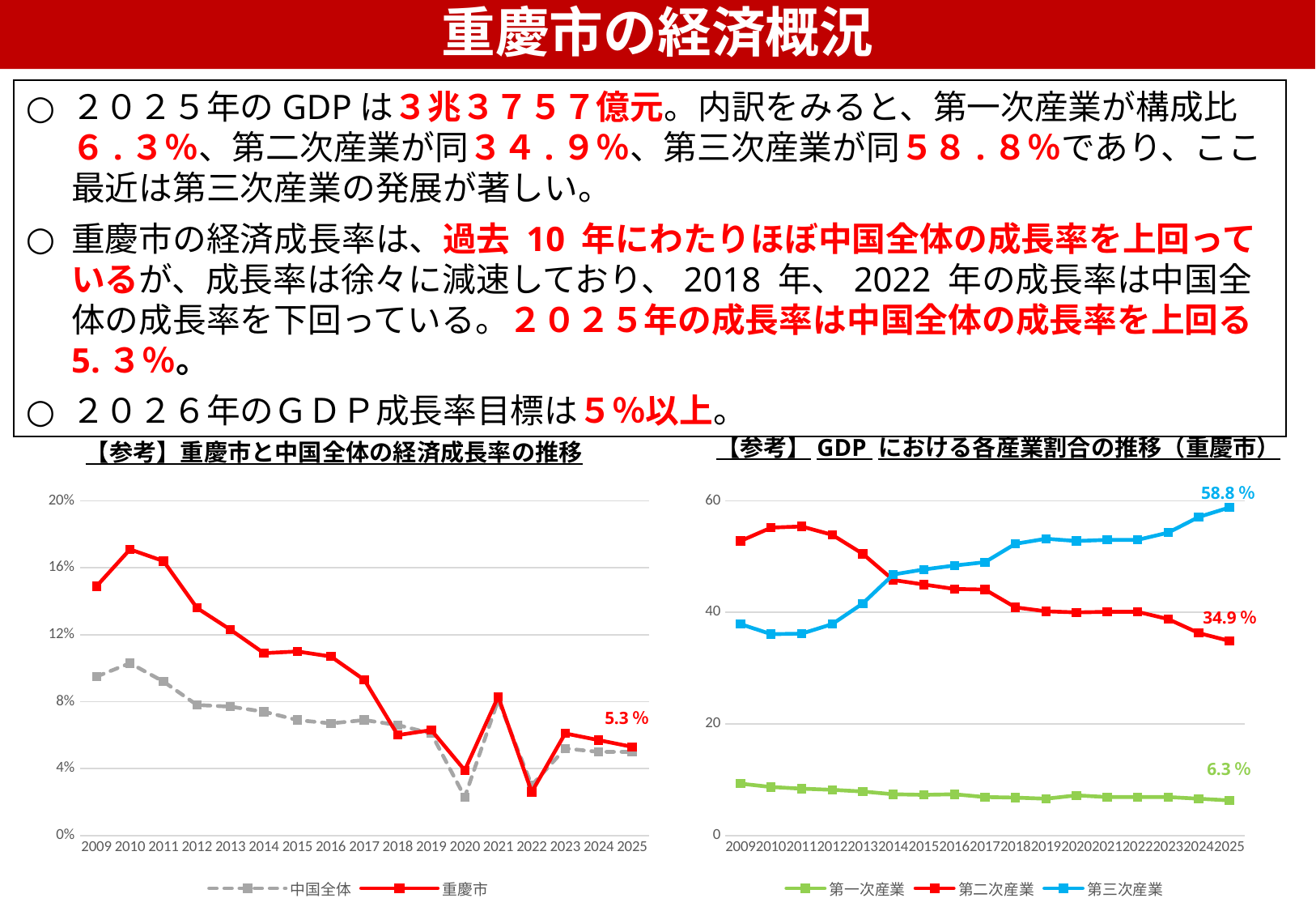
On the right chart (GDP における各産業割合の推移), which industry has the lowest share in 2025? 第一次産業 On the right chart (GDP における各産業割合の推移), how many series does the legend list? 3 On the right chart (GDP における各産業割合の推移), what is the share of 第三次産業 in 2025? 58.8% On the left chart (重慶市と中国全体の経済成長率の推移), does the 重慶市 line generally rise or fall from 2010 to 2025? Fall On the left chart (重慶市と中国全体の経済成長率の推移), which series has the higher value in 2010, 重慶市 or 中国全体? 重慶市 On the left chart (重慶市と中国全体の経済成長率の推移), what is the growth rate for 重慶市 in 2025? 5.3% On the right chart (GDP における各産業割合の推移), what is the share of 第二次産業 in 2025? 34.9% On the left chart (重慶市と中国全体の経済成長率の推移), how many series does the legend list? 2 On the left chart (重慶市と中国全体の経済成長率の推移), how many years are shown on the x axis? 17 On the right chart (GDP における各産業割合の推移), what is the difference between the 2025 shares of 第三次産業 and 第二次産業? 23.9% On the left chart (重慶市と中国全体の経済成長率の推移), what kind of chart is it? Line chart On the left chart (重慶市と中国全体の経済成長率の推移), is the value for 重慶市 in 2010 greater or less than 16%? greater